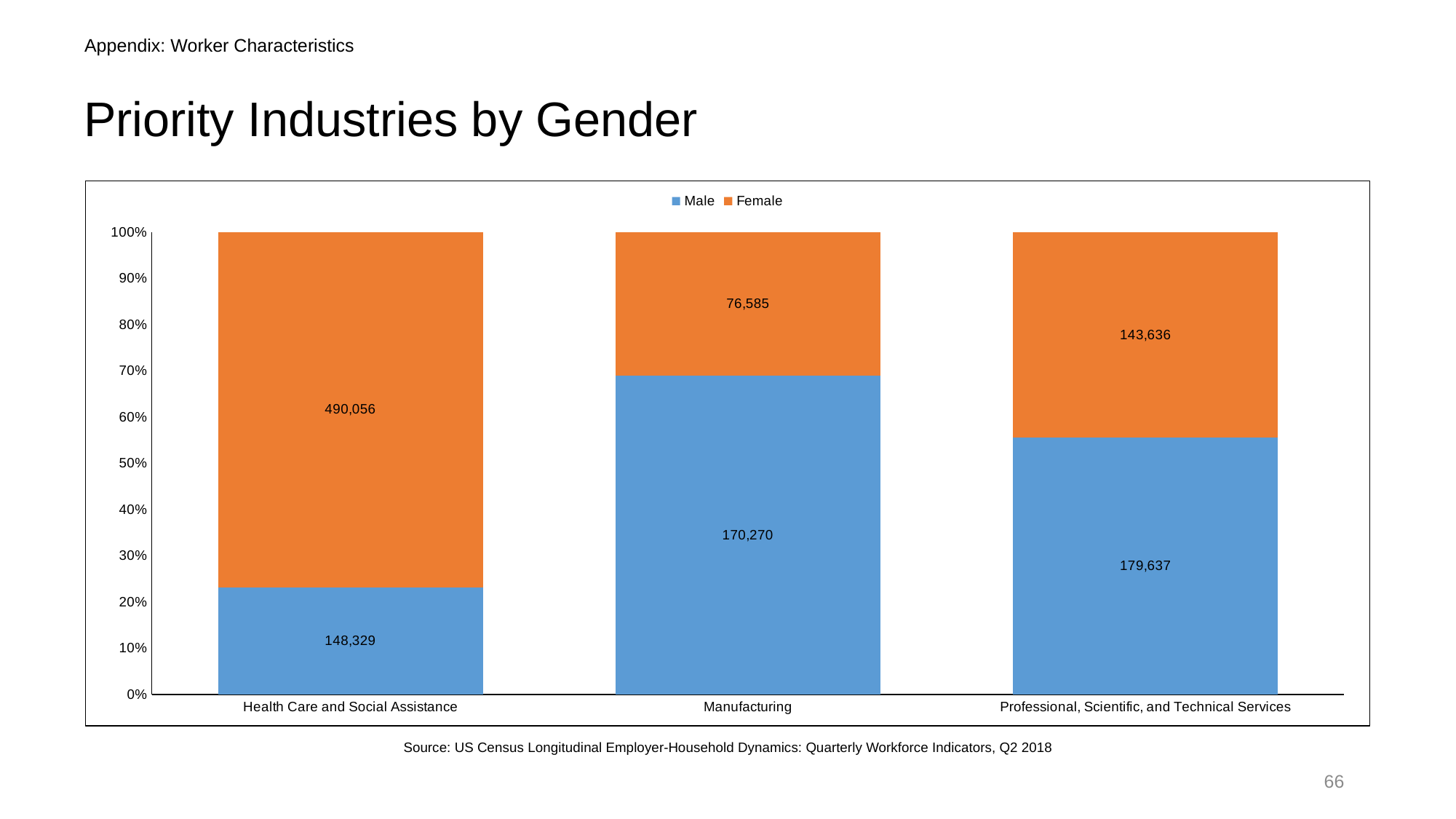
What is the total of the Male and Female values for Manufacturing? 246,855 How many series does the legend list? 2 What is the Female value for Health Care and Social Assistance? 490,056 What is the Female value for Professional, Scientific, and Technical Services? 143,636 Which is larger for Manufacturing, the Male value or the Female value? Male What is the Male value for Manufacturing? 170,270 How many industries are shown on the x axis? 3 What is the difference between the Female and Male values for Health Care and Social Assistance? 341,727 Which industry has the highest Female value? Health Care and Social Assistance What kind of chart is shown on the slide? Stacked bar chart Which industry has the lowest Male value? Health Care and Social Assistance Is the Male share of the Manufacturing bar greater or less than 60%? greater